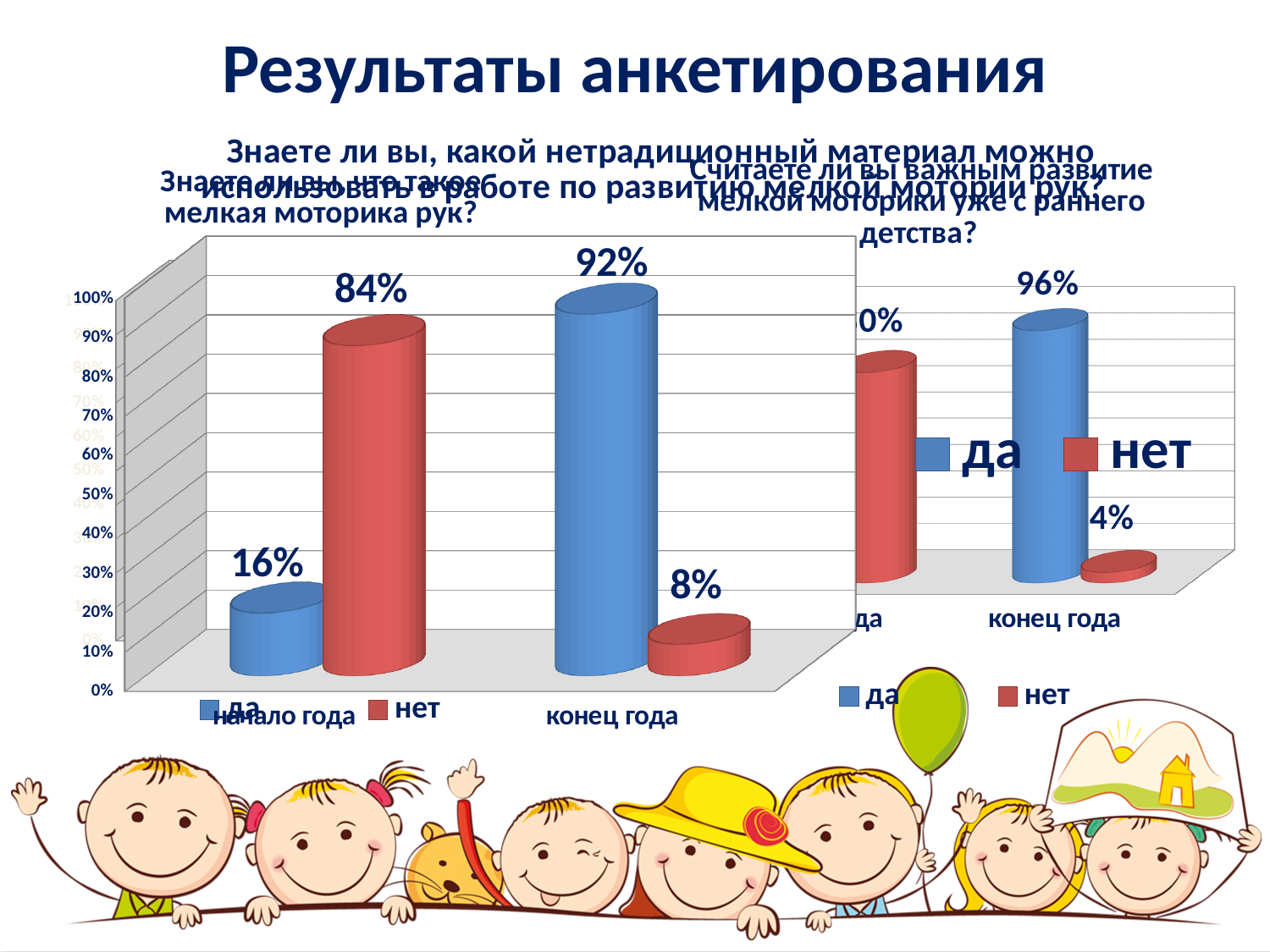
On the large chart in the centre of the slide, what is the value for "нет" at "начало года"? 84% How many series does the legend of the large chart in the centre of the slide list? 2 How many categories are shown on the x axis of the large chart in the centre of the slide? 2 What kind of chart is the large chart in the centre of the slide? bar chart On the large chart in the centre of the slide, what is the value for "нет" at "конец года"? 8% On the large chart in the centre of the slide, what is the difference between "нет" and "да" at "начало года"? 68 percentage points On the chart on the right of the slide, what is the value for "нет" at "конец года"? 4% On the large chart in the centre of the slide, what is the value for "да" at "конец года"? 92% On the large chart in the centre of the slide, does the value for "да" rise or fall from "начало года" to "конец года"? rises On the large chart in the centre of the slide, what is the value for "да" at "начало года"? 16% On the large chart in the centre of the slide, which is larger at "конец года": "да" or "нет"? да On the chart on the right of the slide, what is the value for "да" at "конец года"? 96%